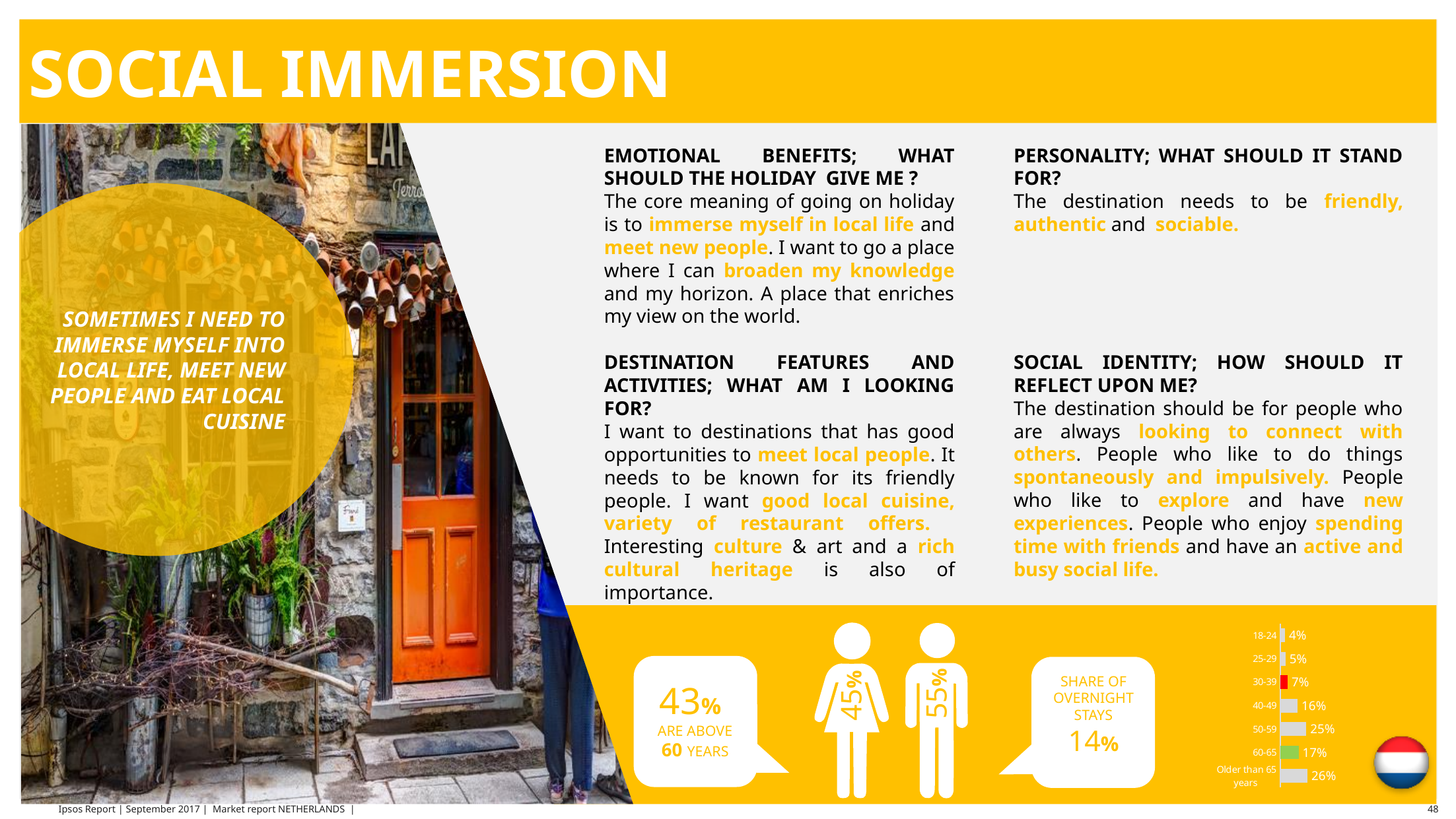
What type of chart is the age-group chart at the bottom right of the slide? Bar chart In the age-group bar chart, which age group has the highest value? Older than 65 years In the age-group bar chart, what is the value for the 50-59 age group? 25% In the age-group bar chart, what is the value for the 40-49 age group? 16% In the age-group bar chart, what is the combined value of the 18-24 and 25-29 groups? 9% In the age-group bar chart, what is the value for the 'Older than 65 years' group? 26% In the age-group bar chart, what is the difference between the 50-59 group and the 60-65 group? 8% In the age-group bar chart, which age group's bar is coloured red? 30-39 In the age-group bar chart, which is larger: the value for 40-49 or the value for 60-65? 60-65 How many age groups are shown in the age-group bar chart? 7 In the age-group bar chart, what is the value for the 30-39 age group? 7% In the age-group bar chart, which age group has the lowest value? 18-24